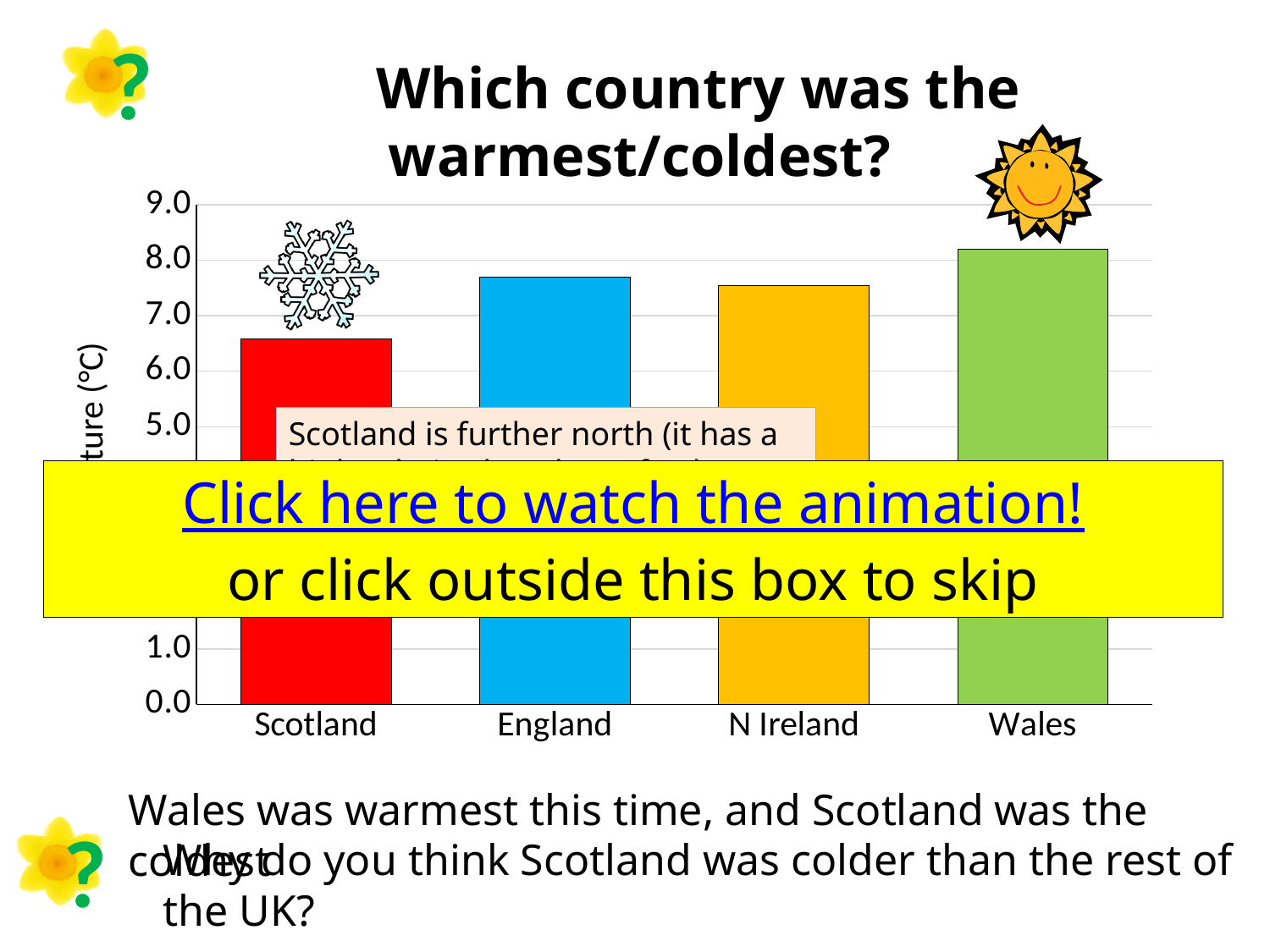
Is the value for England greater or less than 7.0? greater Is the value for N Ireland greater or less than 8.0? less What kind of chart is shown on the slide? bar chart Which country has the highest bar on the chart? Wales What colour is the bar for Scotland? red Which country has the lowest bar on the chart? Scotland Is the value for Scotland greater or less than 7.0? less Which has the larger value, Wales or Scotland? Wales What is the title of the chart? Which country was the warmest/coldest? Which has the larger value, England or Scotland? England How many countries are shown on the chart? 4